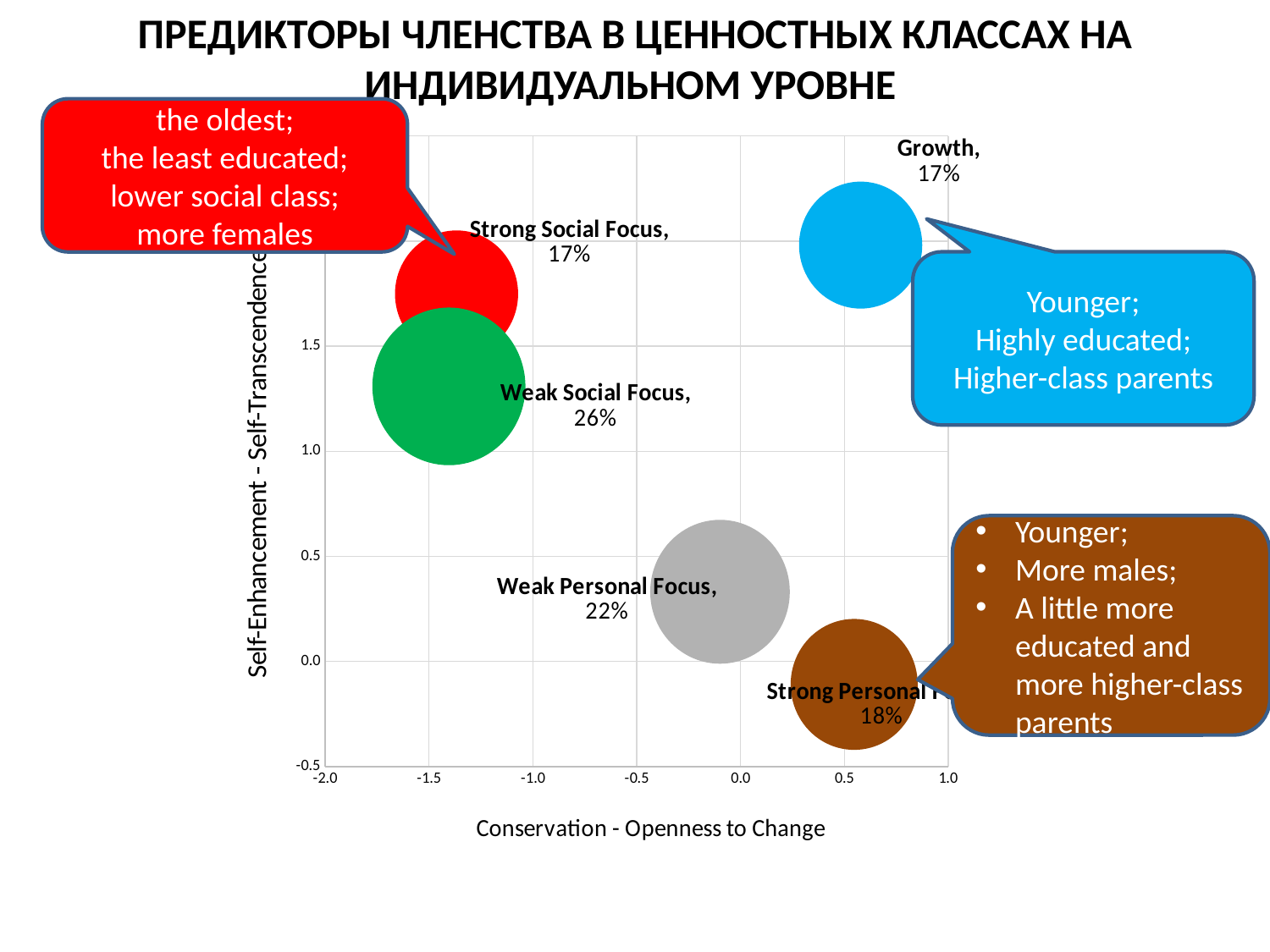
Is the horizontal-axis value for the Strong Social Focus bubble greater or less than -1.0? less What is the title of the horizontal axis? Conservation - Openness to Change What percentage is shown for the Weak Personal Focus bubble? 22% What kind of chart is shown on the slide? Bubble chart Which bubble has the largest percentage? Weak Social Focus Which has a larger percentage, Weak Personal Focus or Growth? Weak Personal Focus Is the vertical-axis value for the Weak Personal Focus bubble greater or less than 0.5? less What percentage is shown for the Strong Social Focus bubble? 17% What percentage is shown for the Growth bubble? 17% How many bubbles are plotted on the chart? 5 What percentage is shown for the Weak Social Focus bubble? 26% What is the difference in percentage between Weak Social Focus and Weak Personal Focus? 4%